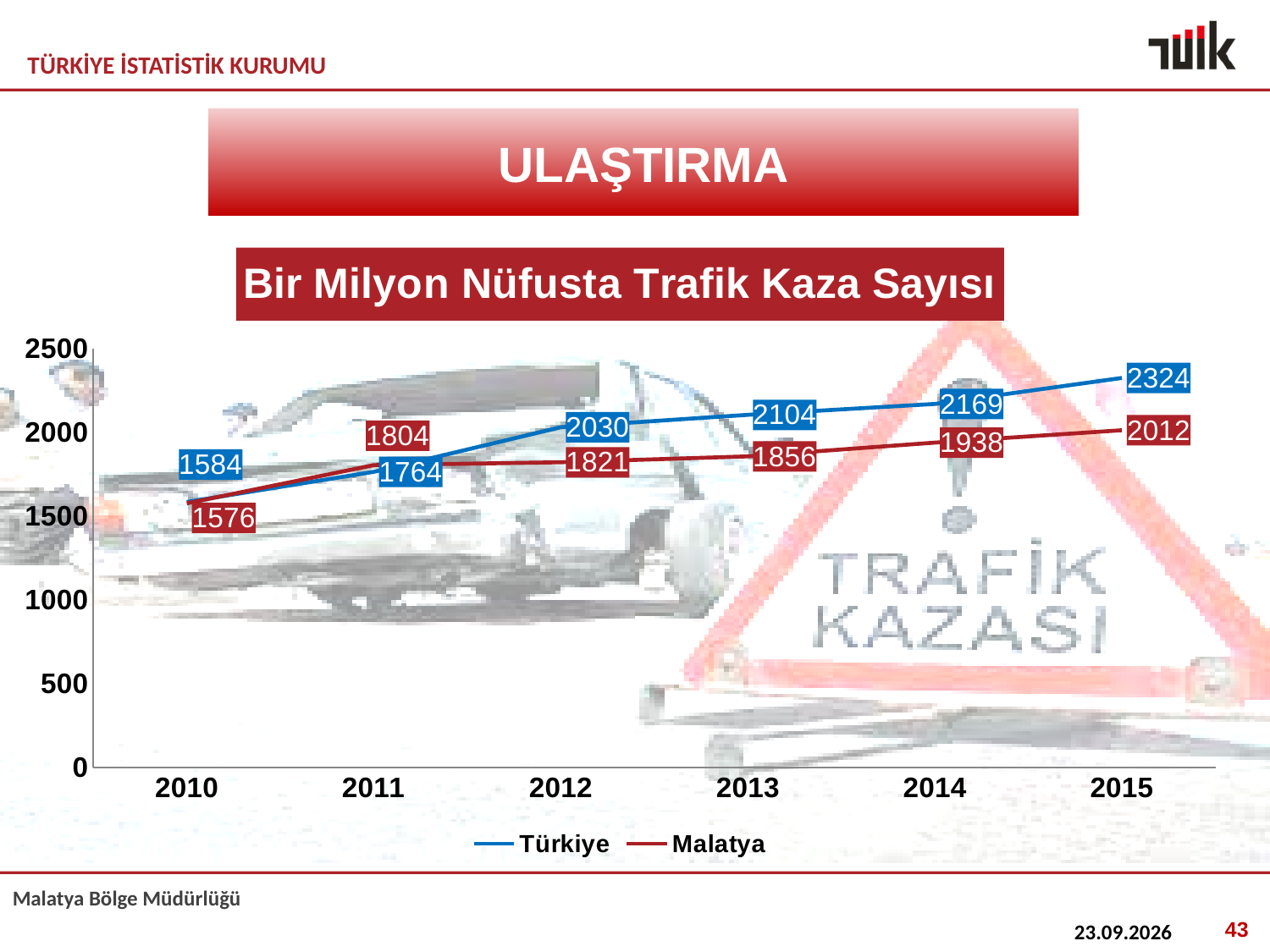
In which year is the Malatya series lowest? 2010 What is the difference between the Türkiye and Malatya values in 2015? 312 What is the value for Türkiye in 2012? 2030 In which year is the Türkiye series highest? 2015 What is the value for Malatya in 2013? 1856 What kind of chart is shown on the slide? line chart How many series does the legend list? 2 Is the value for Türkiye in 2014 greater or less than 2000? greater What is the value for Türkiye in 2015? 2324 How many years are shown on the x axis? 6 Which is larger in 2011, the Türkiye value or the Malatya value? Malatya What is the value for Malatya in 2010? 1576